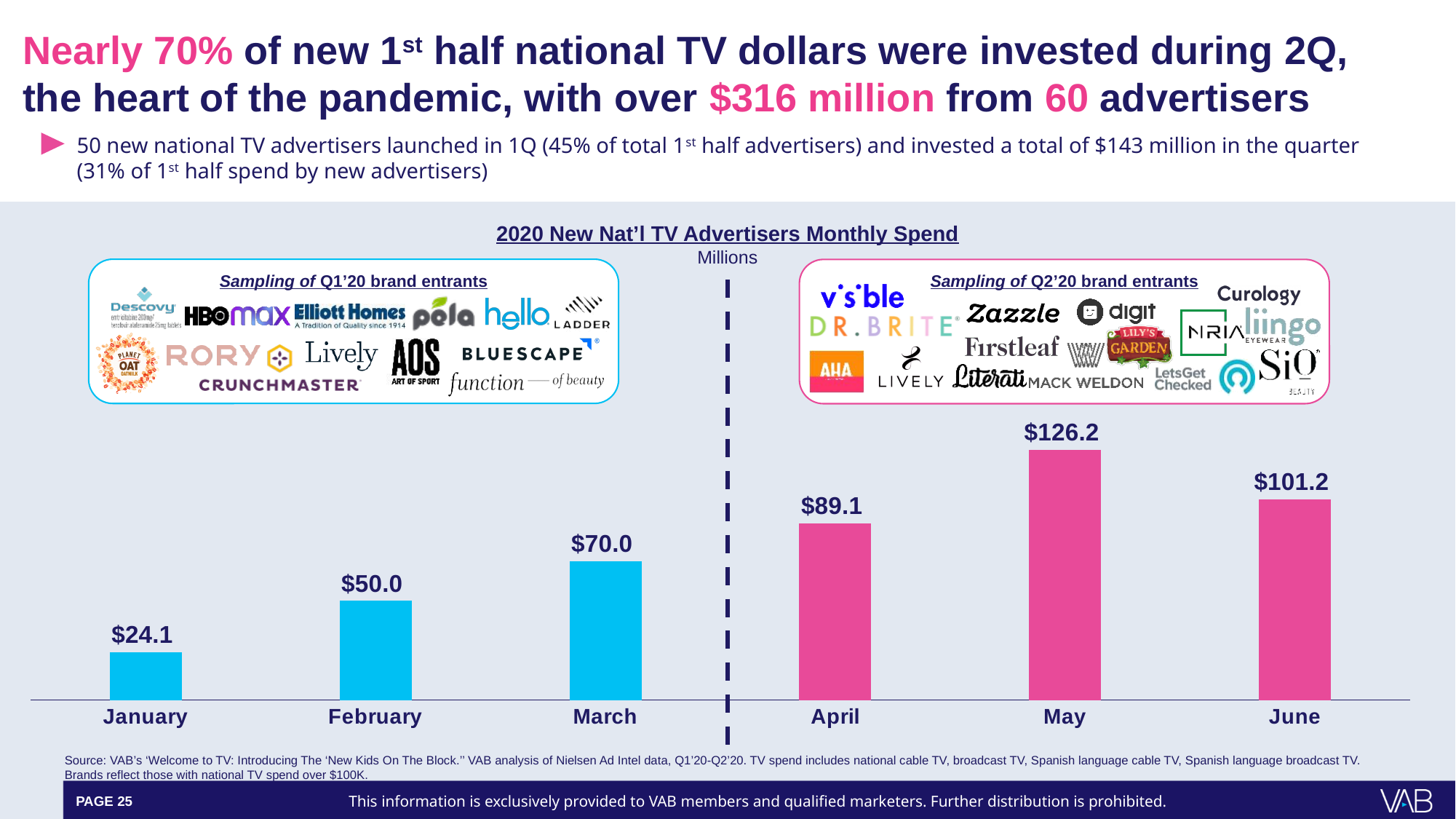
What is the value for April? $89.1 What is the value for January? $24.1 How many months are shown on the chart? 6 Which month has the lowest spend? January What is the difference between the values for March and February? $20.0 Which month has the highest spend? May What kind of chart is this? Bar chart Which is larger, the value for April or the value for June? June Do the values rise or fall from January to May? Rise What is the difference between the values for May and June? $25.0 What is the value for May? $126.2 What is the title of the chart? 2020 New Nat'l TV Advertisers Monthly Spend